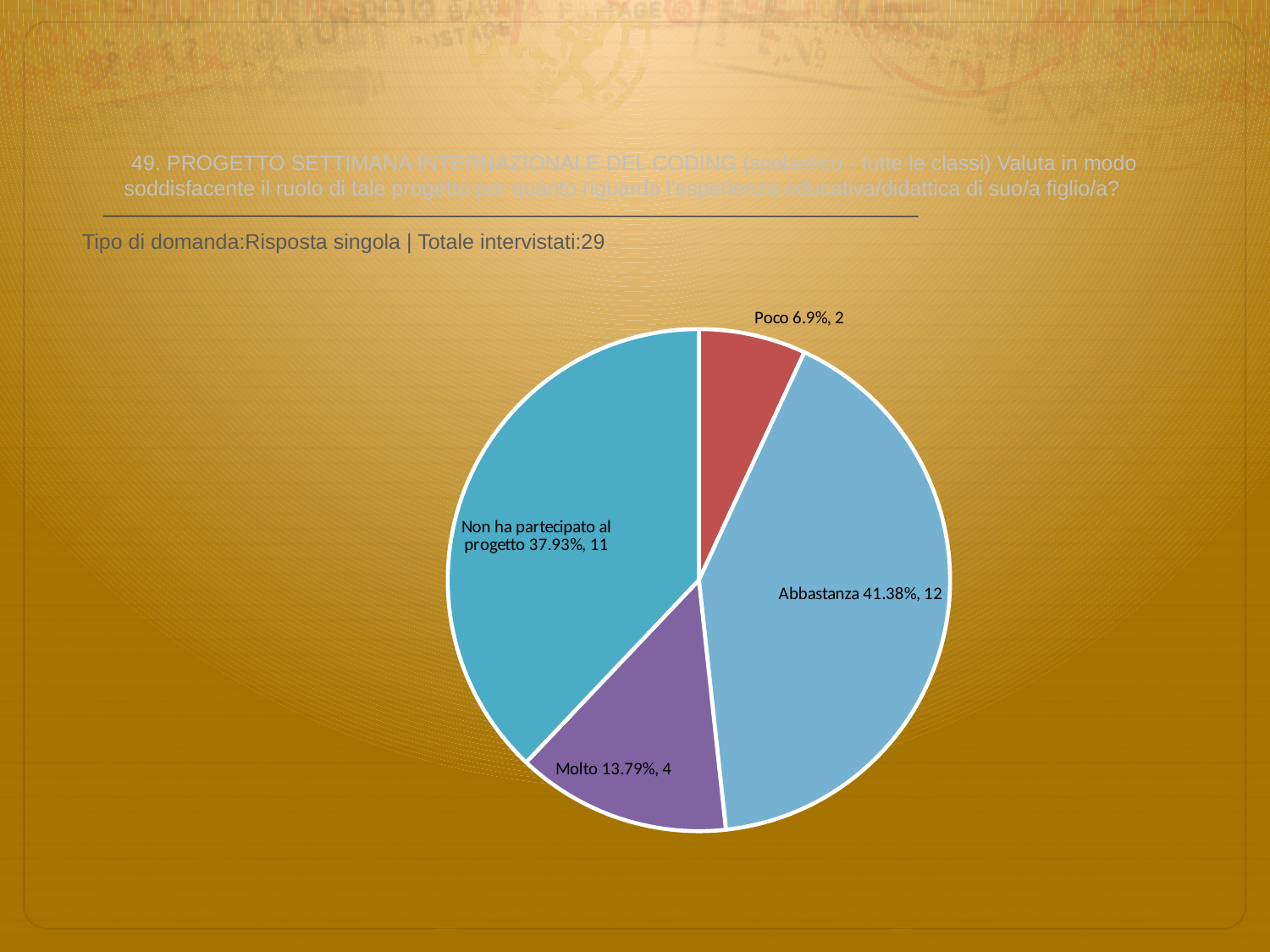
How many respondents are in the 'Non ha partecipato al progetto' slice? 11 How many slices does the pie chart have? 4 What percentage share does the 'Poco' slice have? 6.9% What percentage share does the 'Abbastanza' slice have? 41.38% How many respondents chose 'Molto'? 4 What is the difference in respondent count between 'Abbastanza' and 'Non ha partecipato al progetto'? 1 What kind of chart is shown on the slide? pie chart Which has more respondents, 'Molto' or 'Poco'? Molto Which category has the smallest slice of the pie? Poco What colour is the 'Molto' slice? purple What is the total number of respondents (Totale intervistati) stated on the slide? 29 Which category has the largest slice of the pie? Abbastanza